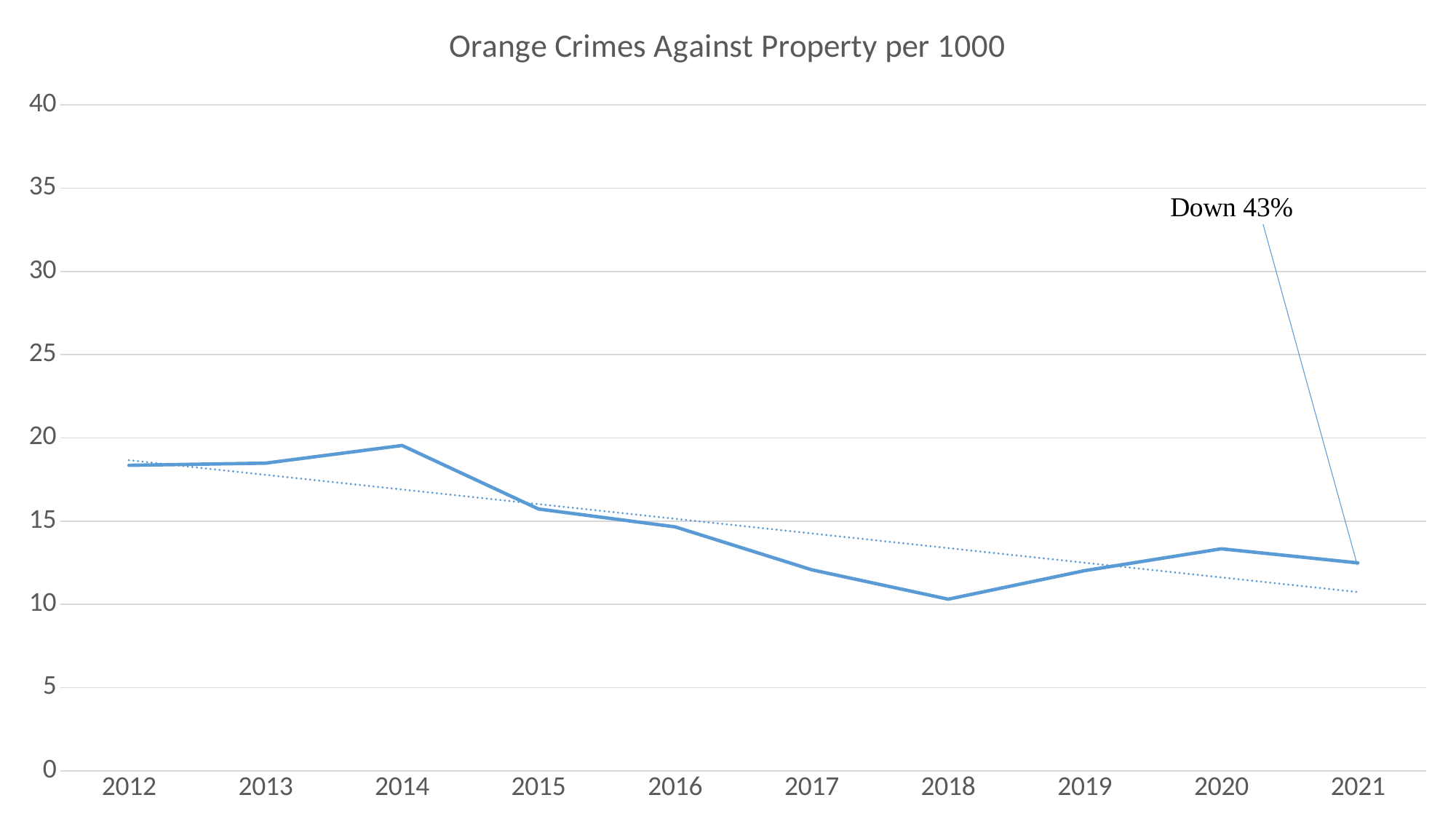
Which year has the highest value? 2014 Which year has the larger value, 2014 or 2017? 2014 What does the annotation near the 2021 point say? Down 43% Which year has the lowest value? 2018 How many years are plotted along the x axis? 10 What is the title of the chart? Orange Crimes Against Property per 1000 Is the value for 2012 greater or less than 20? less Do the values generally rise or fall from 2012 to 2021? fall Is the value for 2014 greater or less than 15? greater What kind of chart is shown on the slide? line chart Is the value for 2021 greater or less than 10? greater